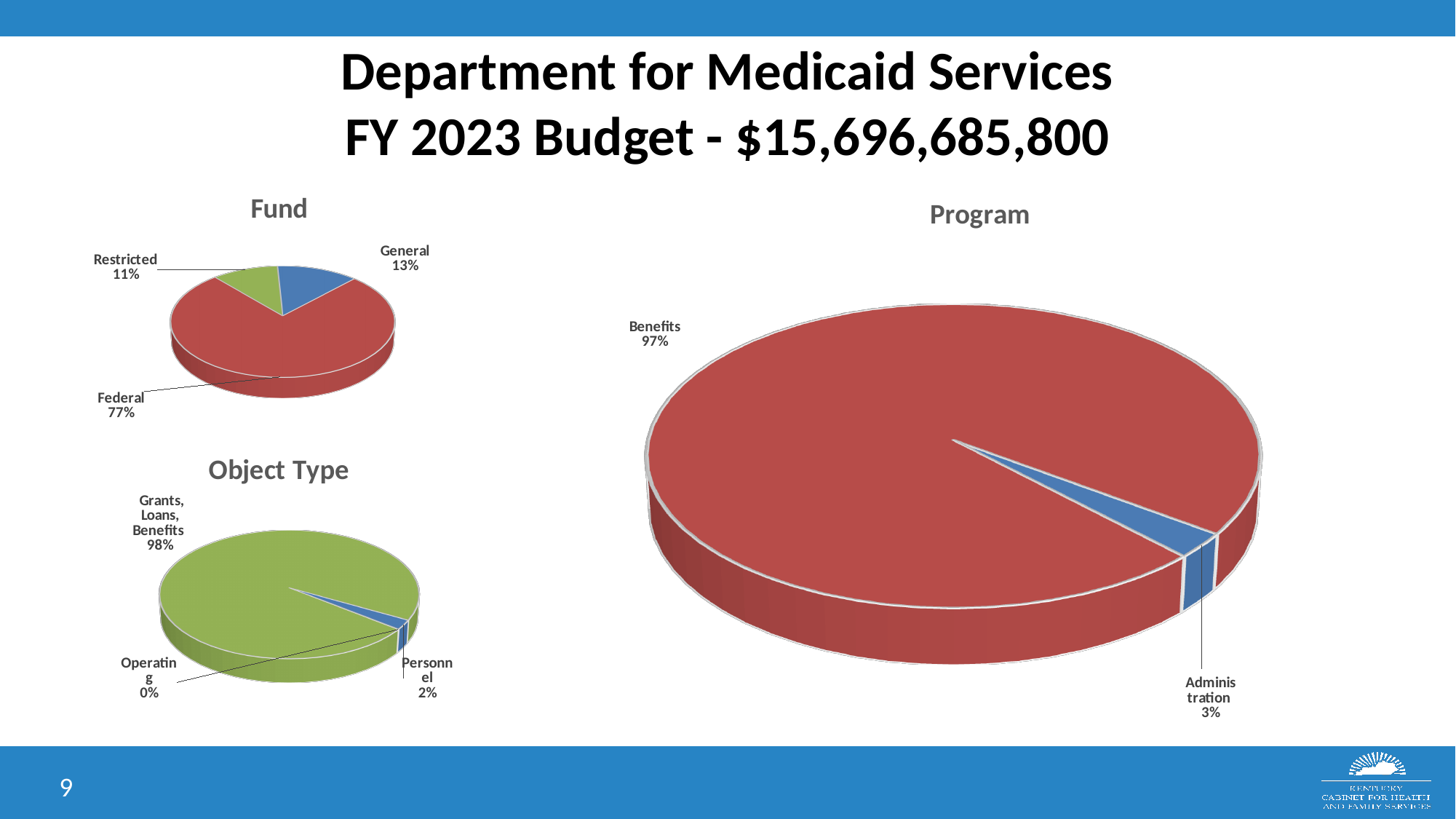
In the Fund chart, which fund source has the largest share? Federal In the Fund chart, what is the difference in percentage points between Federal and General? 64 In the Fund chart, which fund source has the smallest share? Restricted In the Program chart, what share is Administration? 3% In the Fund chart, what share of the budget is Restricted? 11% In the Object Type chart, what share is Personnel? 2% In the Object Type chart, what share is Grants, Loans, Benefits? 98% In the Fund chart, how many slices does the pie have? 3 In the Object Type chart, which category has the smallest share? Operating In the Program chart, which is larger, Benefits or Administration? Benefits In the Fund chart, what share of the budget is Federal? 77% What kind of chart is the Program chart? Pie chart